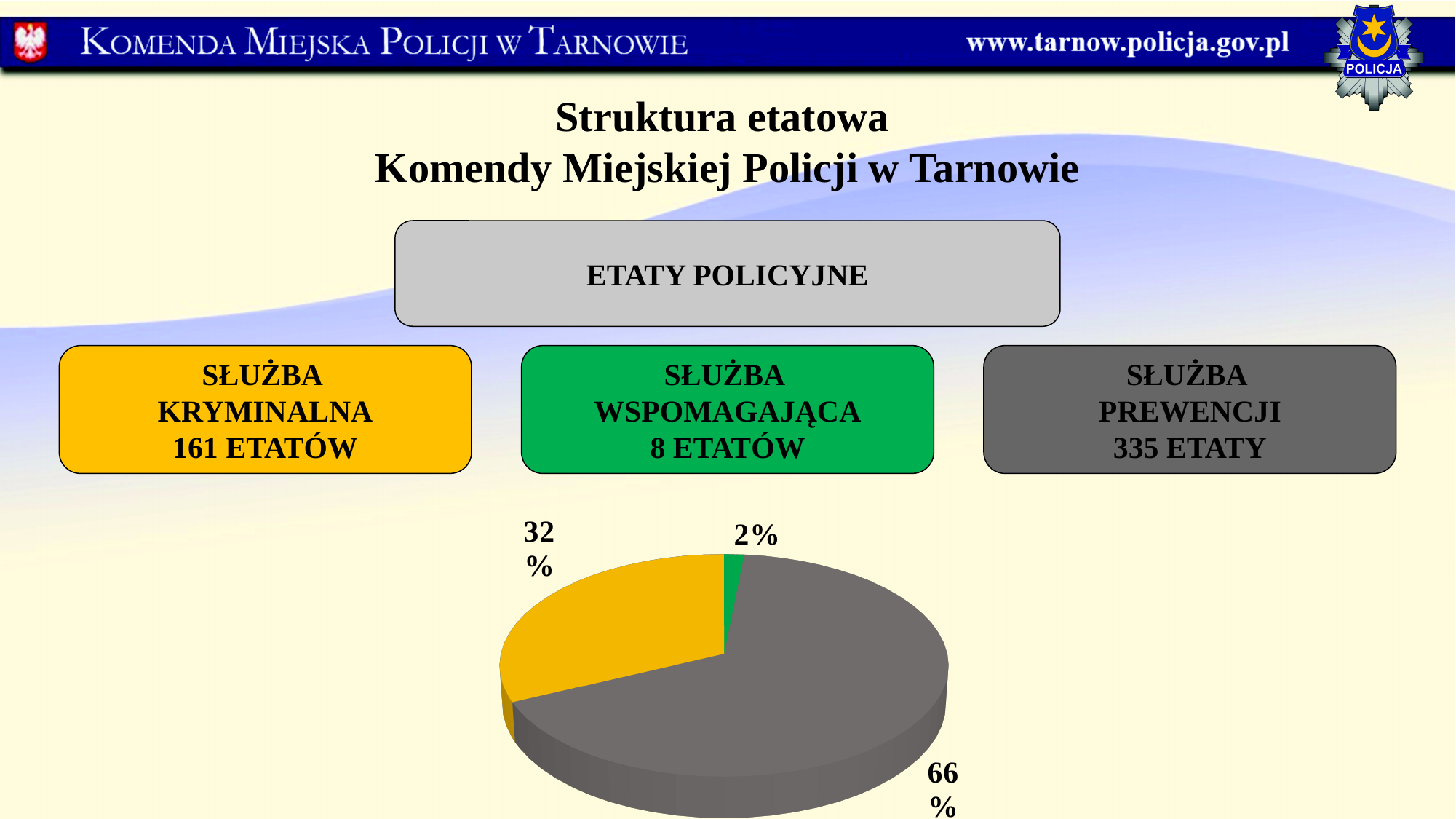
What kind of chart is shown on the slide? pie chart What share of the pie does the yellow slice represent? 32% What share of the pie does the grey slice represent? 66% What share of the pie does the green slice represent? 2% What is the difference in percentage points between the grey slice and the yellow slice? 34 Which slice of the pie chart is the largest? the grey slice (66%) What colour is the slice representing 2% of the pie? green Which slice of the pie chart is the smallest? the green slice (2%) How many slices does the pie chart have? 3 Is the share of the grey slice greater or less than 50%? greater Which is larger in the pie chart, the yellow slice or the green slice? the yellow slice What is the difference in percentage points between the yellow slice and the green slice? 30